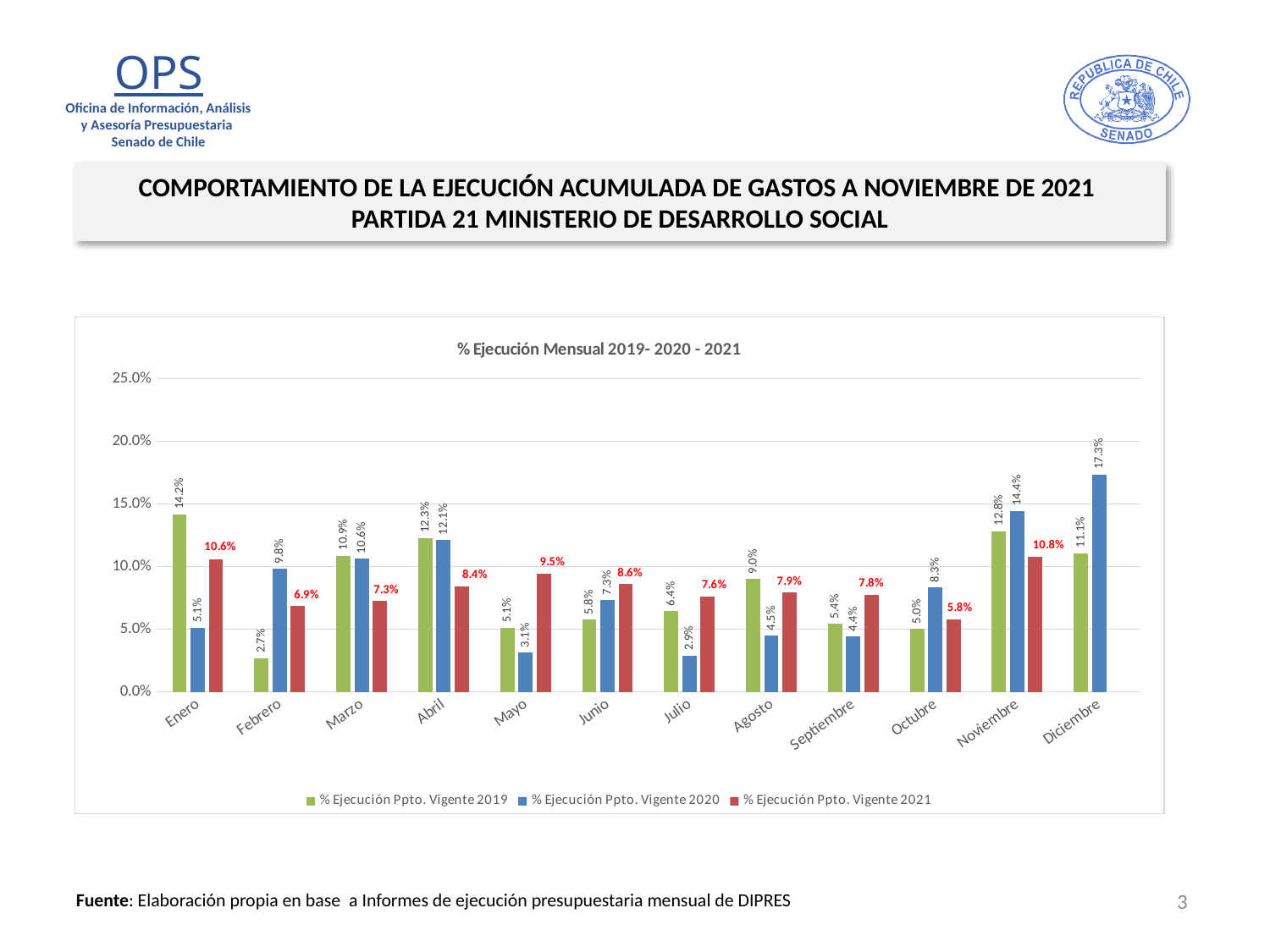
How many months are shown on the x axis? 12 Which month has the highest value for % Ejecución Ppto. Vigente 2021? Noviembre Which month has the lowest value for % Ejecución Ppto. Vigente 2019? Febrero What is the value for % Ejecución Ppto. Vigente 2020 in Diciembre? 17.3% Is the value for % Ejecución Ppto. Vigente 2020 in Julio greater or less than 5.0%? less What is the title of the chart? % Ejecución Mensual 2019- 2020 - 2021 What is the value for % Ejecución Ppto. Vigente 2021 in Enero? 10.6% What is the difference between the 2020 and 2019 values in Noviembre? 1.6% In Mayo, which series is larger: % Ejecución Ppto. Vigente 2019 or % Ejecución Ppto. Vigente 2021? % Ejecución Ppto. Vigente 2021 How many series does the legend list? 3 What kind of chart is shown on the slide? Bar chart What is the value for % Ejecución Ppto. Vigente 2019 in Abril? 12.3%